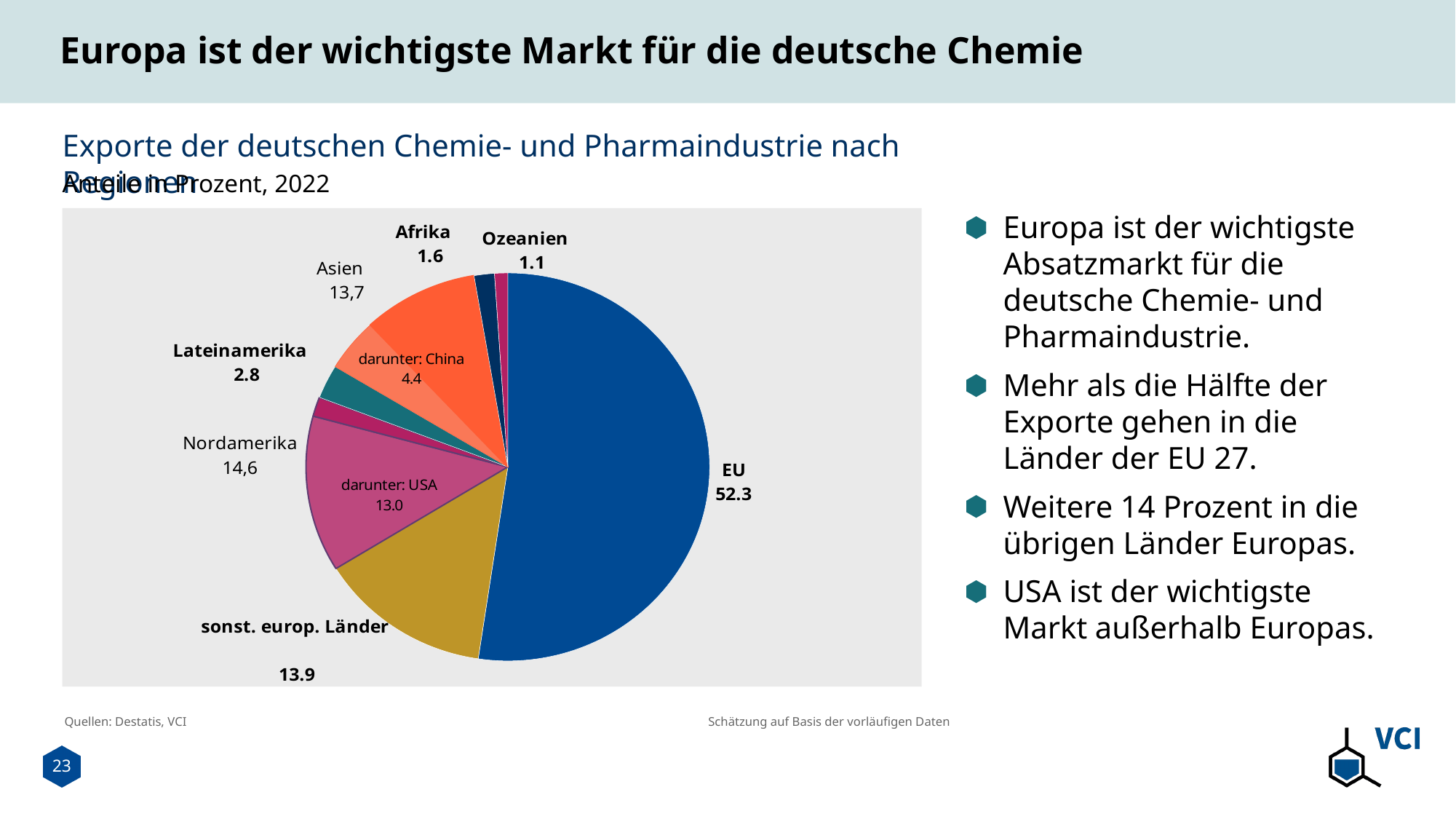
Which region has the smallest slice of the pie? Ozeanien What kind of chart is shown on the slide? Pie chart Which is larger, the value for Nordamerika or the value for Asien? Nordamerika What is the value shown for Nordamerika? 14,6 What value is shown for 'darunter: USA'? 13.0 What is the difference between the values for Afrika and Ozeanien? 0.5 What is the difference between the values for EU and sonst. europ. Länder? 38.4 What is the value shown for sonst. europ. Länder? 13.9 Which year do the data in the chart refer to? 2022 What value is shown for 'darunter: China'? 4.4 What is the value shown for EU in the pie chart? 52.3 Which region has the largest slice of the pie? EU